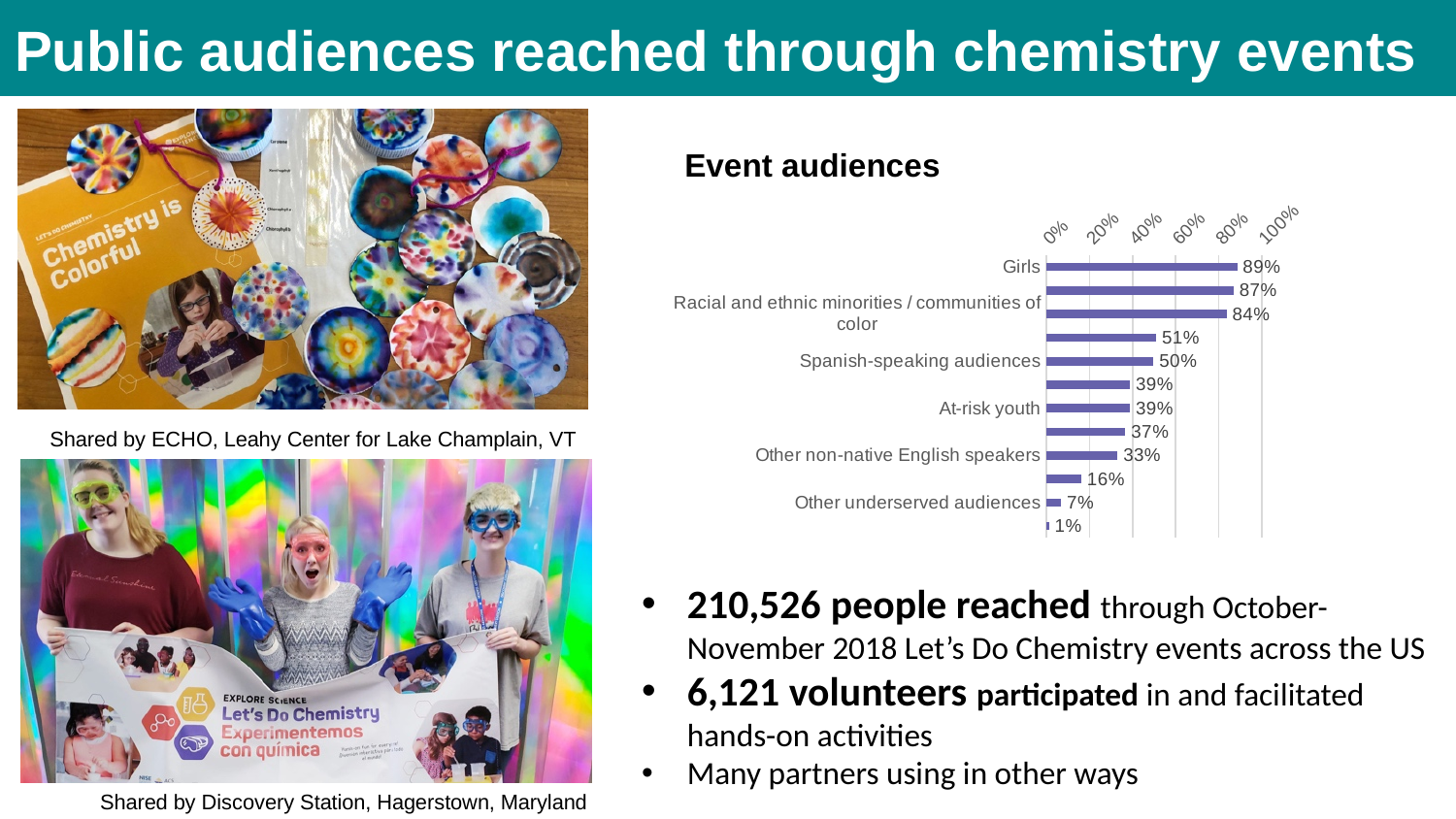
What is the title of the chart on the slide? Event audiences What type of chart is shown under the title "Event audiences"? bar chart In the Event audiences chart, what percentage is shown for Other non-native English speakers? 33% In the Event audiences chart, which labeled category has the highest percentage? Girls How many bars are plotted in the Event audiences chart? 12 In the Event audiences chart, what percentage is shown for At-risk youth? 39% In the Event audiences chart, what percentage is shown for Girls? 89% In the Event audiences chart, which is larger: the value for Girls or the value for At-risk youth? Girls In the Event audiences chart, what is the difference in percentage points between Girls and Spanish-speaking audiences? 39 percentage points In the Event audiences chart, what is the smallest percentage value shown on any bar? 1% In the Event audiences chart, what percentage is shown for Spanish-speaking audiences? 50% In the Event audiences chart, what percentage is shown for Other underserved audiences? 7%